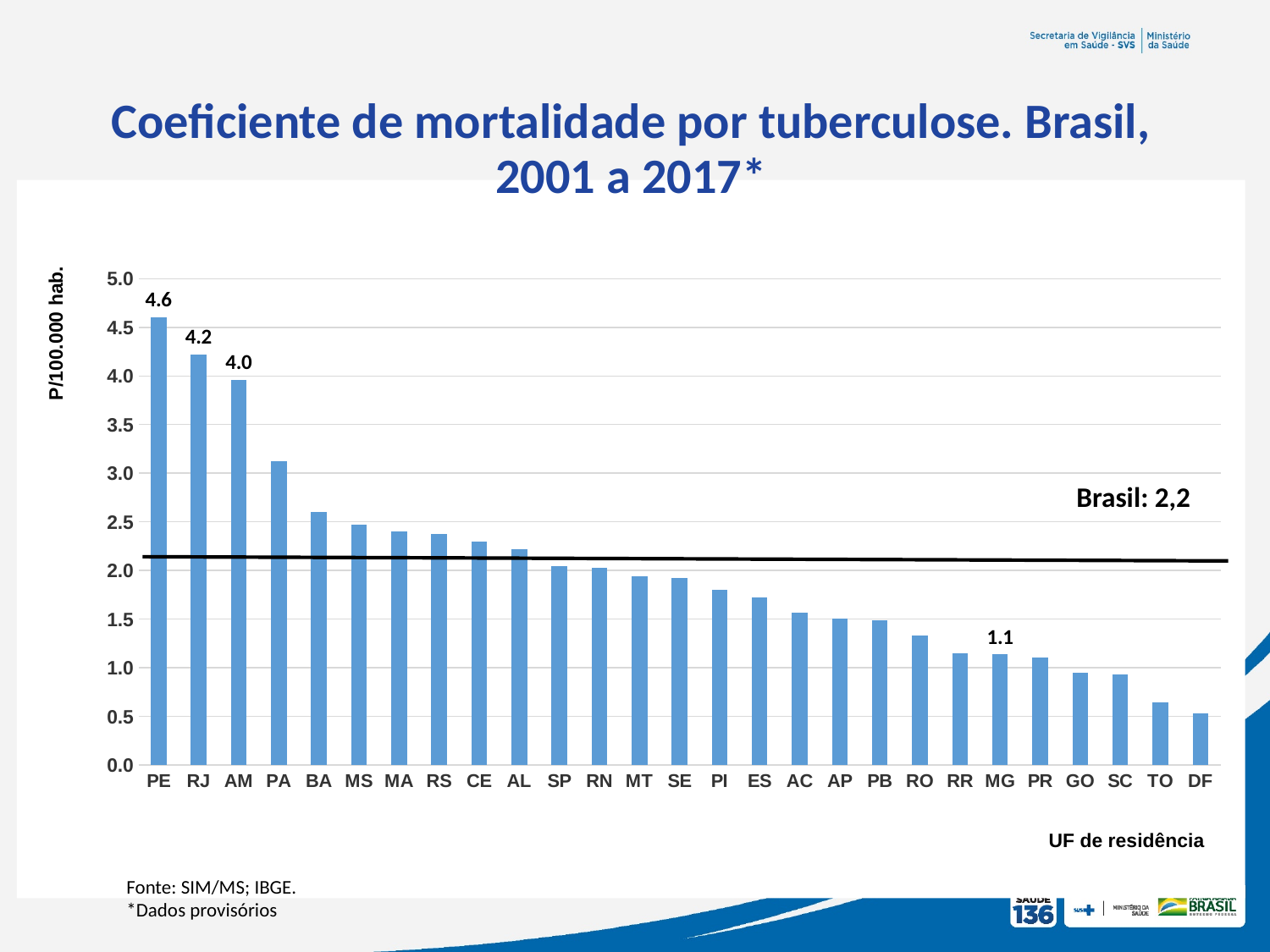
What kind of chart is shown on the slide? bar chart How many UFs are shown on the x axis? 27 What is the difference between the values for PE and RJ? 0.4 Which is larger, the value for PA or the value for BA? PA Is the value for DF greater or less than 1.0? less Is the value for PA greater or less than 3.0? greater What is the value for RJ? 4.2 Which UF has the highest value? PE Which UF has the lowest value? DF What value is given for Brasil by the horizontal reference line? 2,2 What is the value for MG? 1.1 What is the value for PE? 4.6